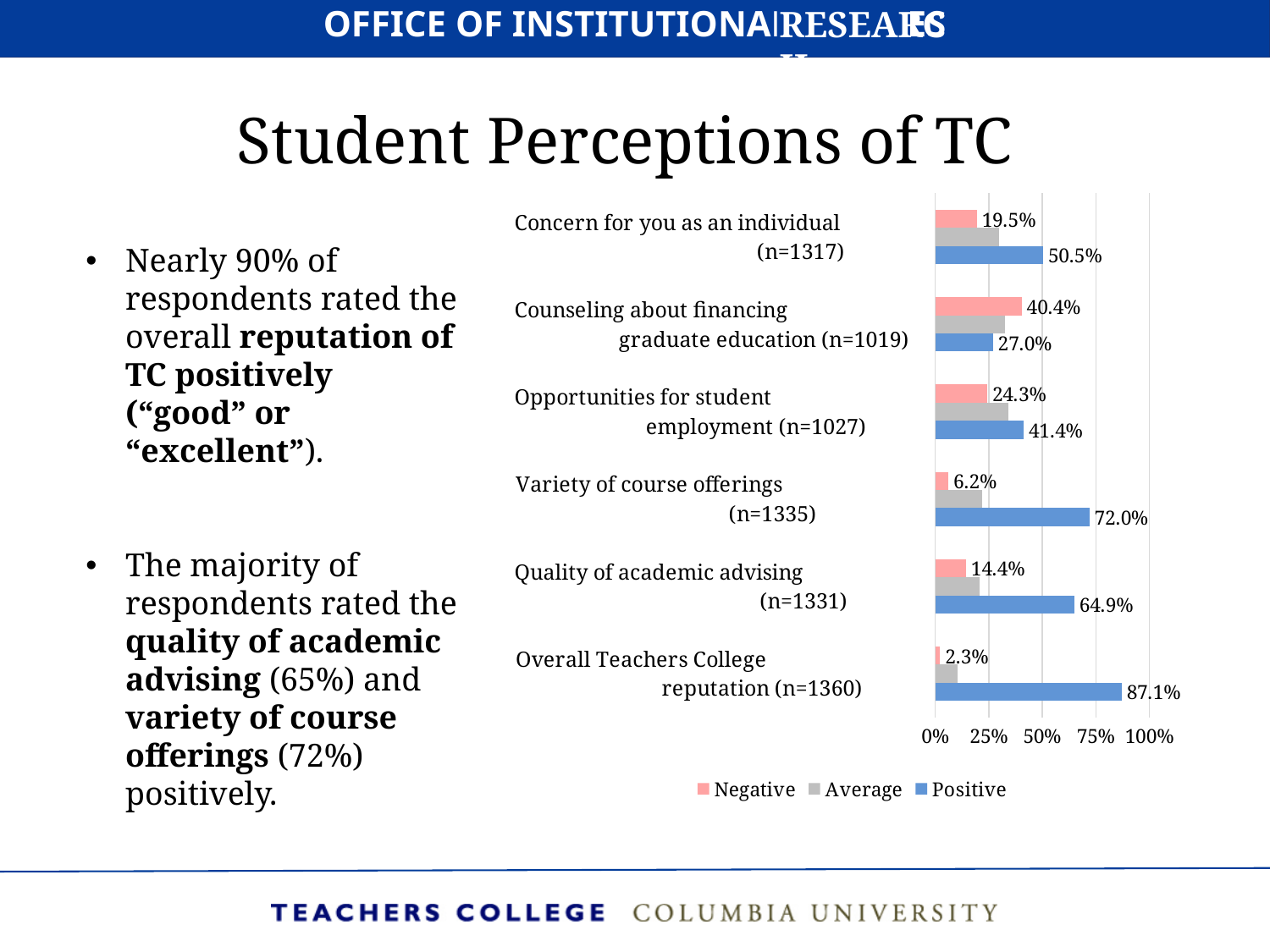
How many categories are plotted in the chart? 6 Which category has the lowest Negative value? Overall Teachers College reputation (n=1360) What kind of chart is shown on the slide? bar chart Which category has the highest Positive value? Overall Teachers College reputation (n=1360) How many series does the legend list? 3 Is the Average value for Overall Teachers College reputation (n=1360) greater or less than 25%? less What is the Positive value for Overall Teachers College reputation (n=1360)? 87.1% What is the Positive value for Quality of academic advising (n=1331)? 64.9% What is the difference between the Positive values for Variety of course offerings (n=1335) and Quality of academic advising (n=1331)? 7.1% Which series is shown in blue in the legend? Positive What is the Negative value for Counseling about financing graduate education (n=1019)? 40.4% Which is larger for Counseling about financing graduate education (n=1019): the Negative value or the Positive value? Negative